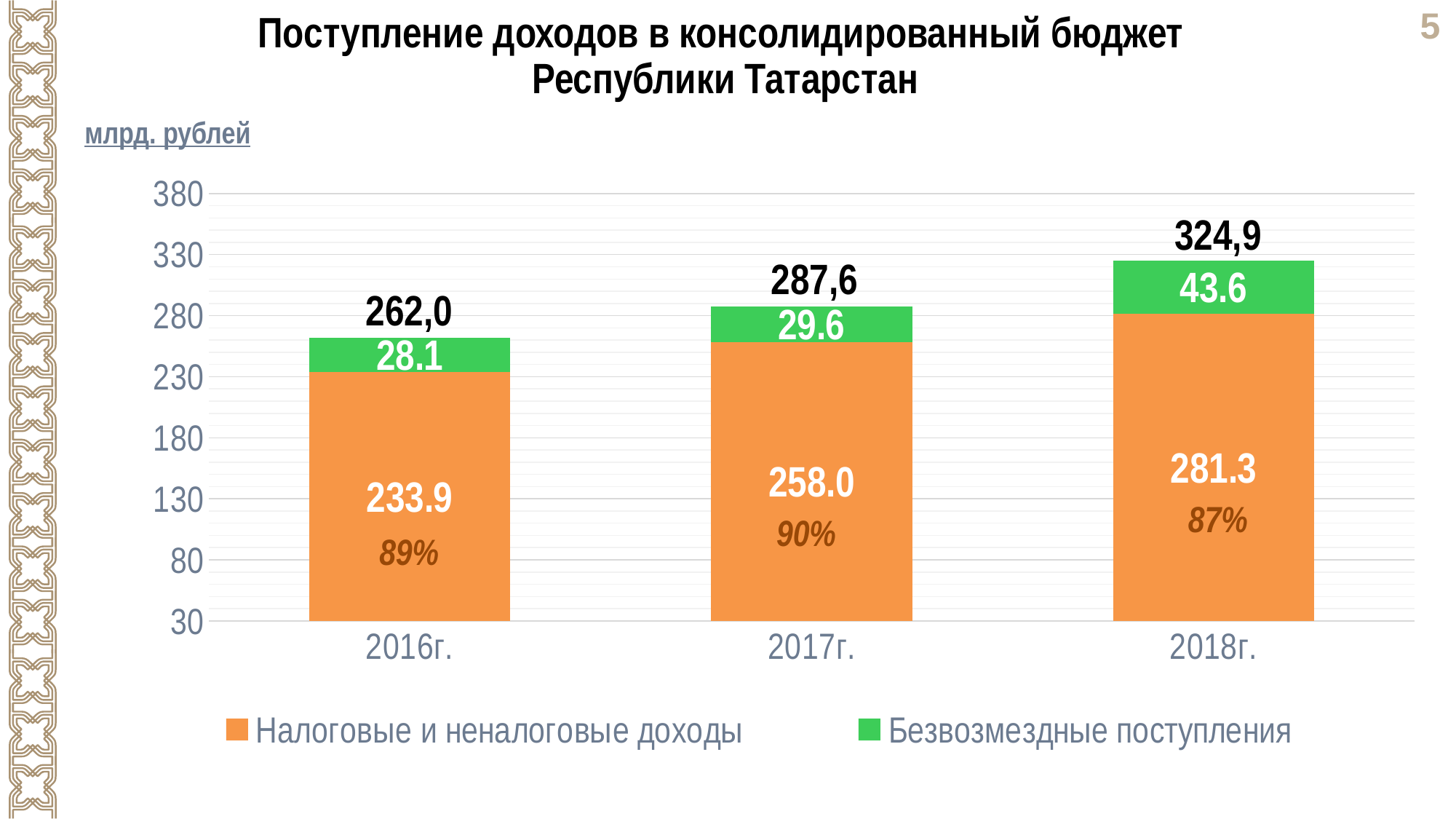
What percentage share is printed inside the orange segment for 2017г.? 90% Do the total revenues rise or fall from 2016г. to 2018г.? Rise What is the total shown above the stacked bar for 2016г.? 262,0 Which year has the highest total revenue? 2018г. Which is larger: Безвозмездные поступления in 2017г. or in 2018г.? 2018г. What is the difference between Налоговые и неналоговые доходы in 2018г. and 2017г.? 23.3 What is the value of Безвозмездные поступления for 2018г.? 43.6 How many years are shown on the x axis? 3 Which year has the lowest value for Безвозмездные поступления? 2016г. What kind of chart is shown on the slide? Stacked bar chart What is the value of Налоговые и неналоговые доходы for 2017г.? 258.0 How many series does the legend list? 2